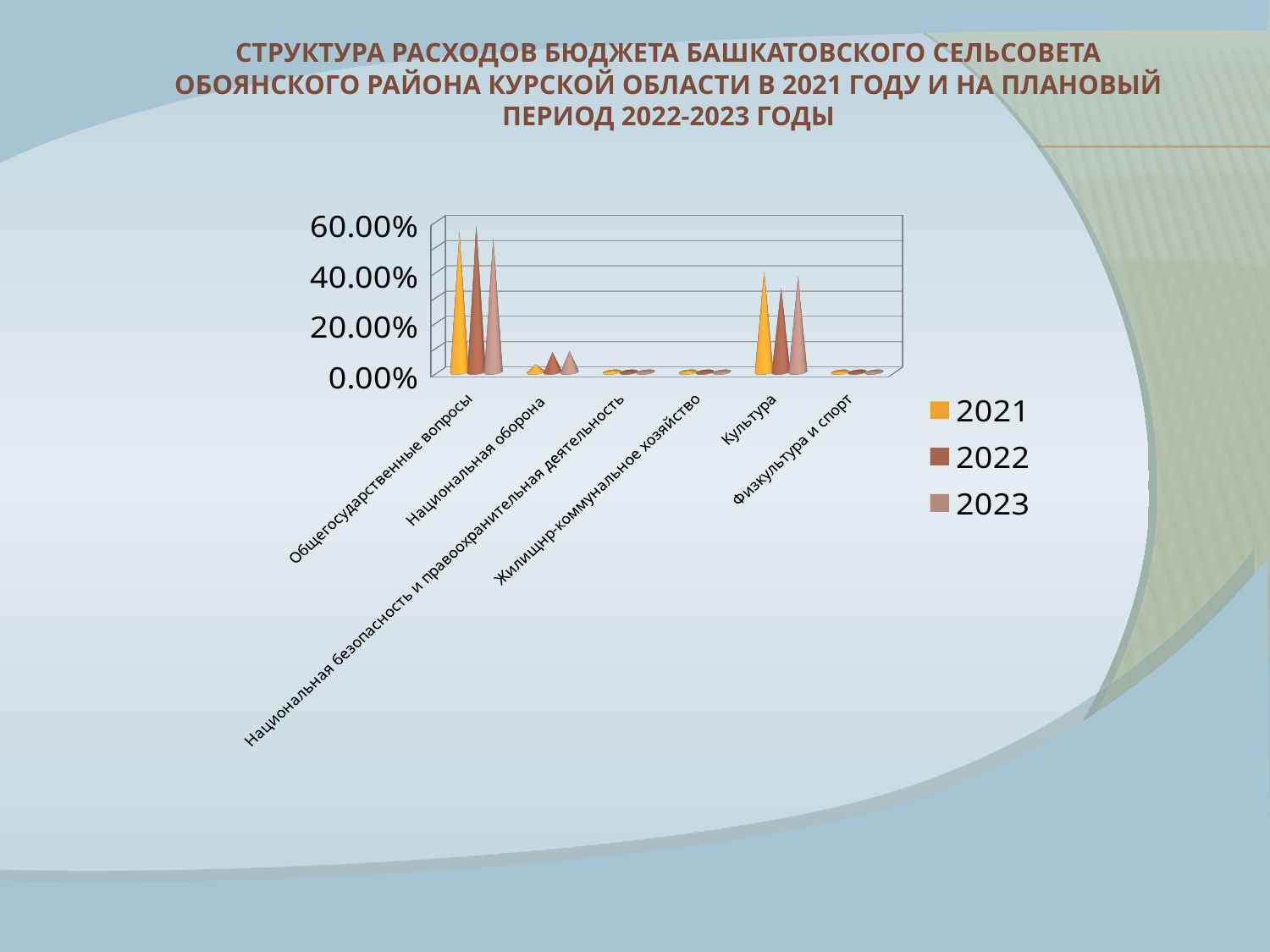
Is the 2021 value for Общегосударственные вопросы greater or less than 40%? greater How many categories are shown on the x axis of the chart? 6 What kind of chart is shown on the slide? Bar chart Is the 2021 value for Культура greater or less than 20%? greater Is the 2022 value for Национальная оборона greater or less than 20%? less Which category has the highest value for the 2023 series? Общегосударственные вопросы For the 2022 series, which is larger: Общегосударственные вопросы or Культура? Общегосударственные вопросы For the 2023 series, which is larger: Культура or Национальная оборона? Культура Which series are listed in the chart legend? 2021, 2022, 2023 How many series does the chart legend list? 3 Which category has the highest value for the 2021 series? Общегосударственные вопросы